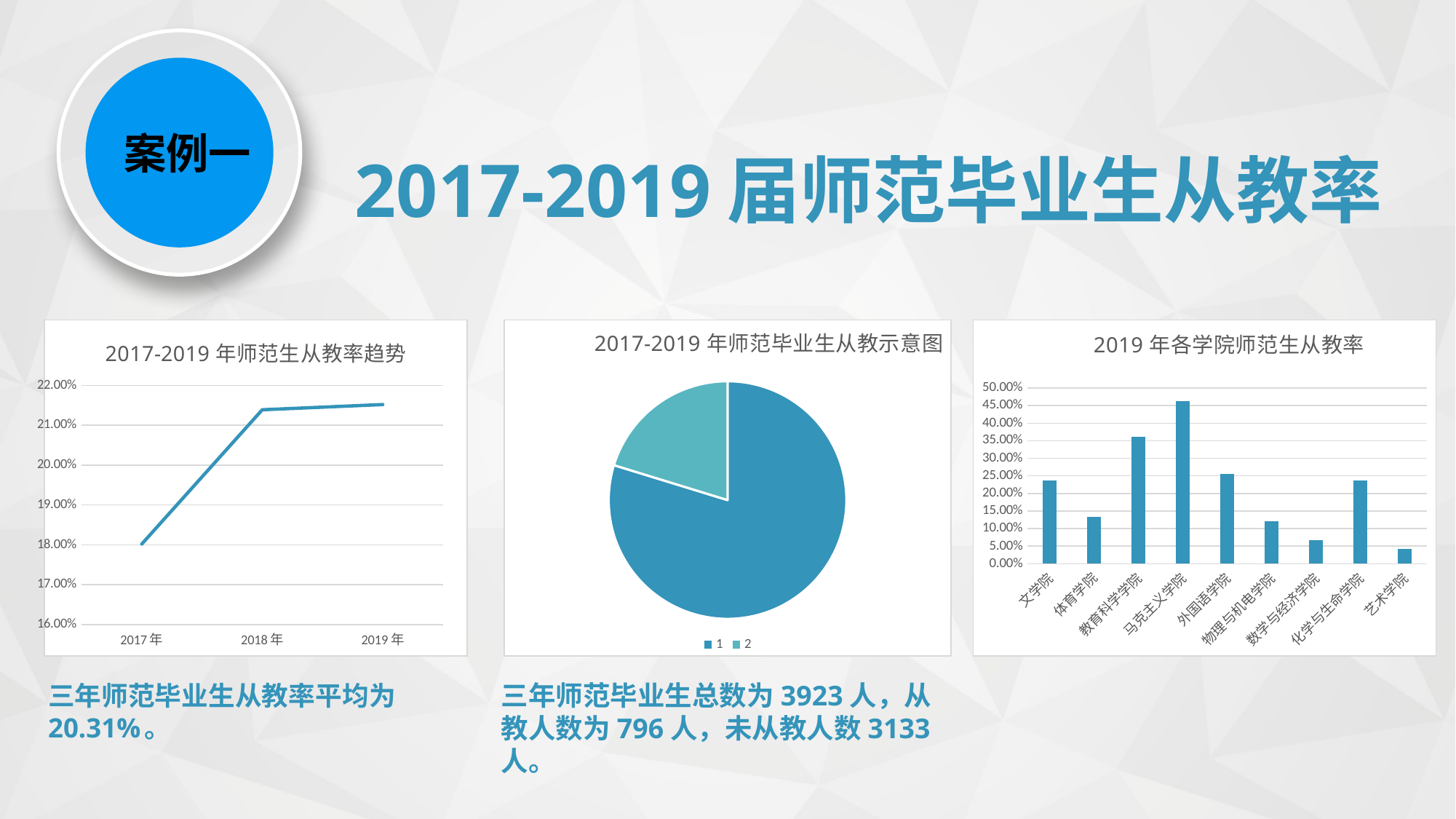
In the chart titled '2017-2019 年师范毕业生从教示意图', how many entries does the legend list? 2 In the chart titled '2019 年各学院师范生从教率', how many categories are shown on the x axis? 9 In the chart titled '2017-2019 年师范毕业生从教示意图', which slice is larger, 1 or 2? 1 What kind of chart is the chart titled '2017-2019 年师范生从教率趋势'? line chart In the chart titled '2017-2019 年师范生从教率趋势', how many years are plotted on the x axis? 3 In the chart titled '2019 年各学院师范生从教率', which category has the highest value? 马克主义学院 In the chart titled '2017-2019 年师范生从教率趋势', is the value for 2018 年 greater or less than 21.00%? greater In the chart titled '2017-2019 年师范生从教率趋势', is the value for 2017 年 greater or less than 19.00%? less What kind of chart is the chart titled '2017-2019 年师范毕业生从教示意图'? pie chart In the chart titled '2017-2019 年师范生从教率趋势', does the value rise or fall from 2017 年 to 2019 年? rise In the chart titled '2019 年各学院师范生从教率', which category has the lowest value? 艺术学院 In the chart titled '2019 年各学院师范生从教率', is the value for 教育科学学院 greater or less than 30.00%? greater